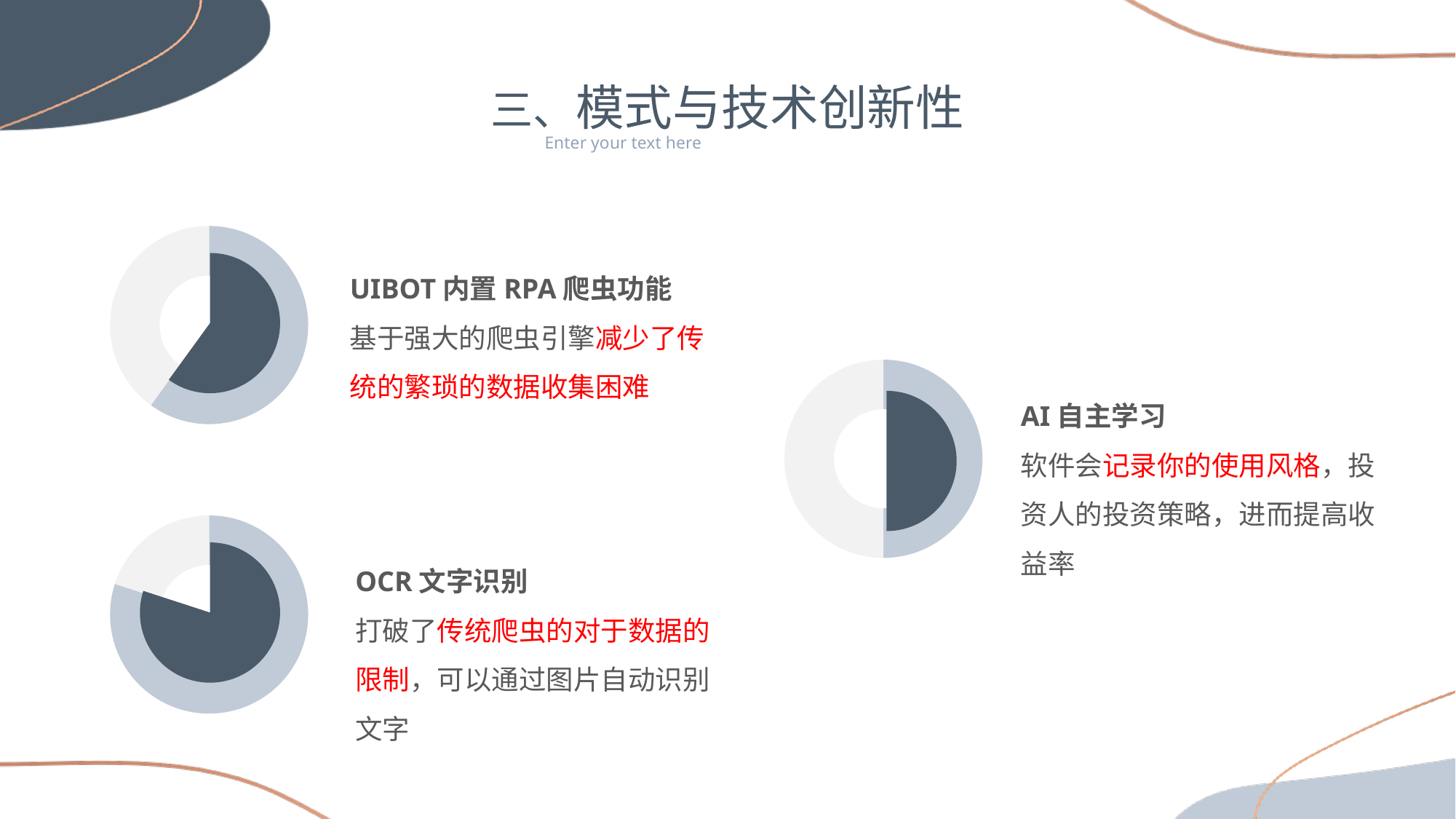
Is the dark filled portion of the chart next to 'OCR 文字识别' larger or smaller than that of the chart next to 'UIBOT 内置 RPA 爬虫功能'? larger What kind of chart is shown next to the 'UIBOT 内置 RPA 爬虫功能' text? pie chart (donut) Do any of the three charts on the slide display numeric data labels? No Which of the three charts has the smallest dark filled portion: the one next to 'UIBOT 内置 RPA 爬虫功能', 'OCR 文字识别', or 'AI 自主学习'? AI 自主学习 How many circular charts are on the slide? 3 Which of the three charts has the largest dark filled portion: the one next to 'UIBOT 内置 RPA 爬虫功能', 'OCR 文字识别', or 'AI 自主学习'? OCR 文字识别 What colour is the filled portion of the charts on the slide? dark slate blue-grey